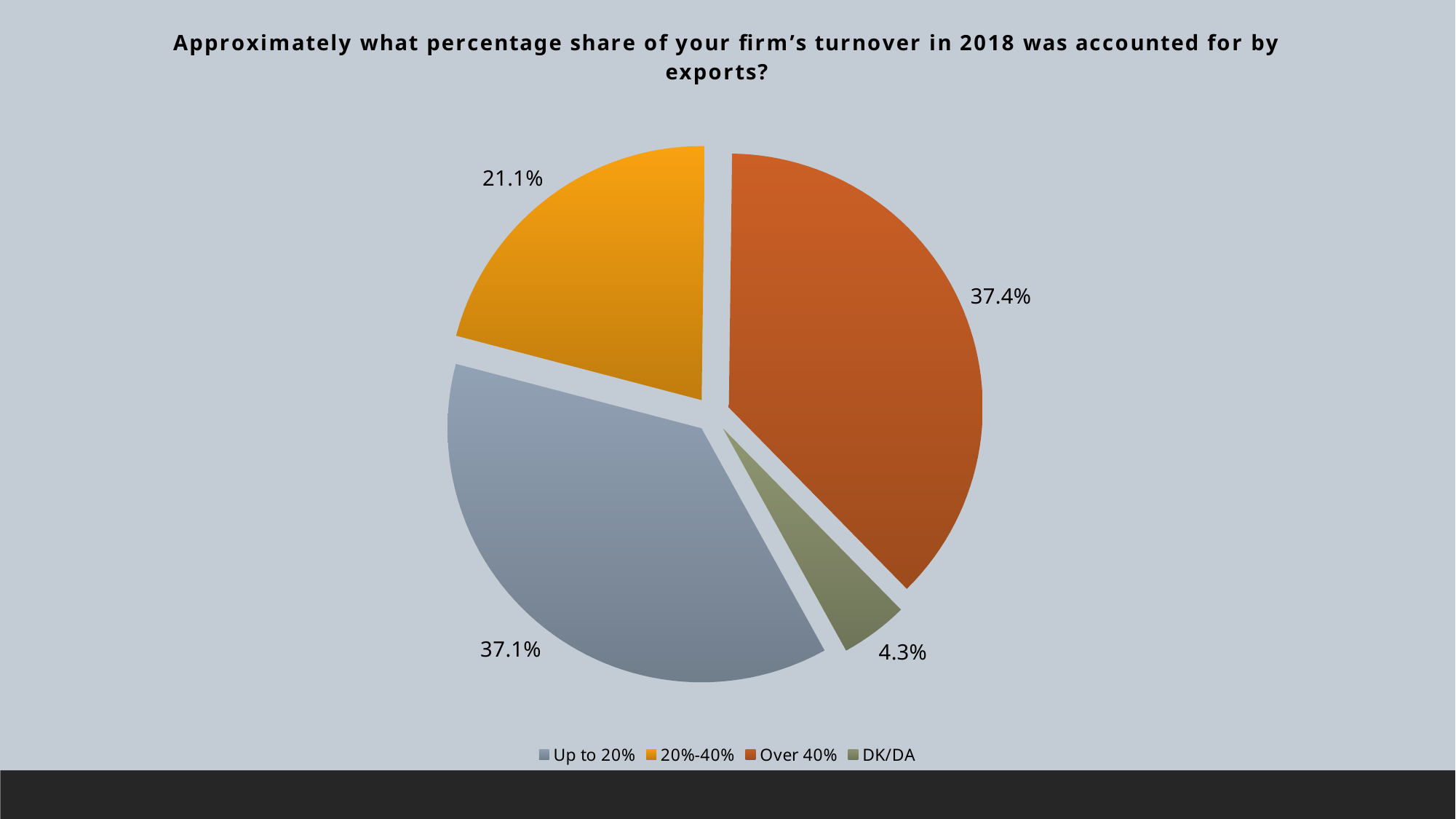
Which category has the smallest slice of the pie? DK/DA What share of the pie does the 'DK/DA' slice represent? 4.3% What colour is the 'Over 40%' slice? Orange-red What kind of chart is shown on the slide? Pie chart Which category has the largest slice of the pie? Over 40% How many categories does the legend list? 4 What is the difference between the 'Over 40%' share and the 'DK/DA' share? 33.1 percentage points What is the difference between the 'Up to 20%' share and the '20%-40%' share? 16.0 percentage points Which slice is larger: '20%-40%' or 'DK/DA'? 20%-40% What share of the pie does the '20%-40%' slice represent? 21.1% What share of the pie does the 'Up to 20%' slice represent? 37.1% What share of the pie does the 'Over 40%' slice represent? 37.4%